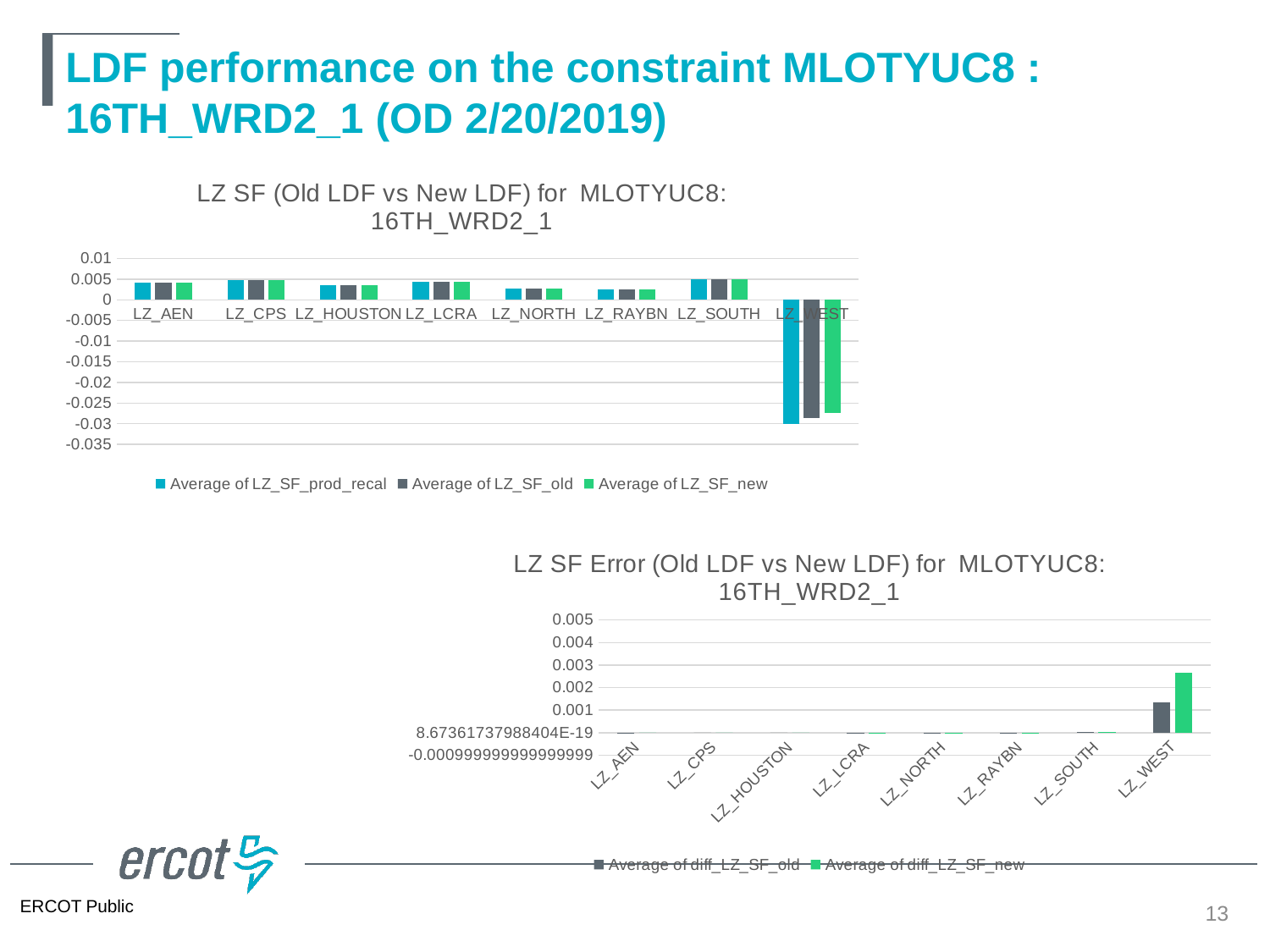
In the top chart (LZ SF), is the value of Average of LZ_SF_prod_recal for LZ_WEST greater or less than -0.02? less In the top chart (LZ SF), what is the first legend entry? Average of LZ_SF_prod_recal In the bottom chart (LZ SF Error), for LZ_WEST, which is larger: Average of diff_LZ_SF_old or Average of diff_LZ_SF_new? Average of diff_LZ_SF_new In the bottom chart (LZ SF Error), which load zone has the highest error values? LZ_WEST In the top chart (LZ SF), how many series does the legend list? 3 In the bottom chart (LZ SF Error), how many series does the legend list? 2 What type of chart is the top chart titled "LZ SF (Old LDF vs New LDF) for MLOTYUC8: 16TH_WRD2_1"? Bar chart In the top chart (LZ SF), how many load zone categories are shown on the x axis? 8 In the top chart (LZ SF), is the value of Average of LZ_SF_new for LZ_AEN greater or less than 0? greater In the top chart (LZ SF), which load zone has the lowest values? LZ_WEST In the bottom chart (LZ SF Error), is the value of Average of diff_LZ_SF_new for LZ_WEST greater or less than 0.002? greater